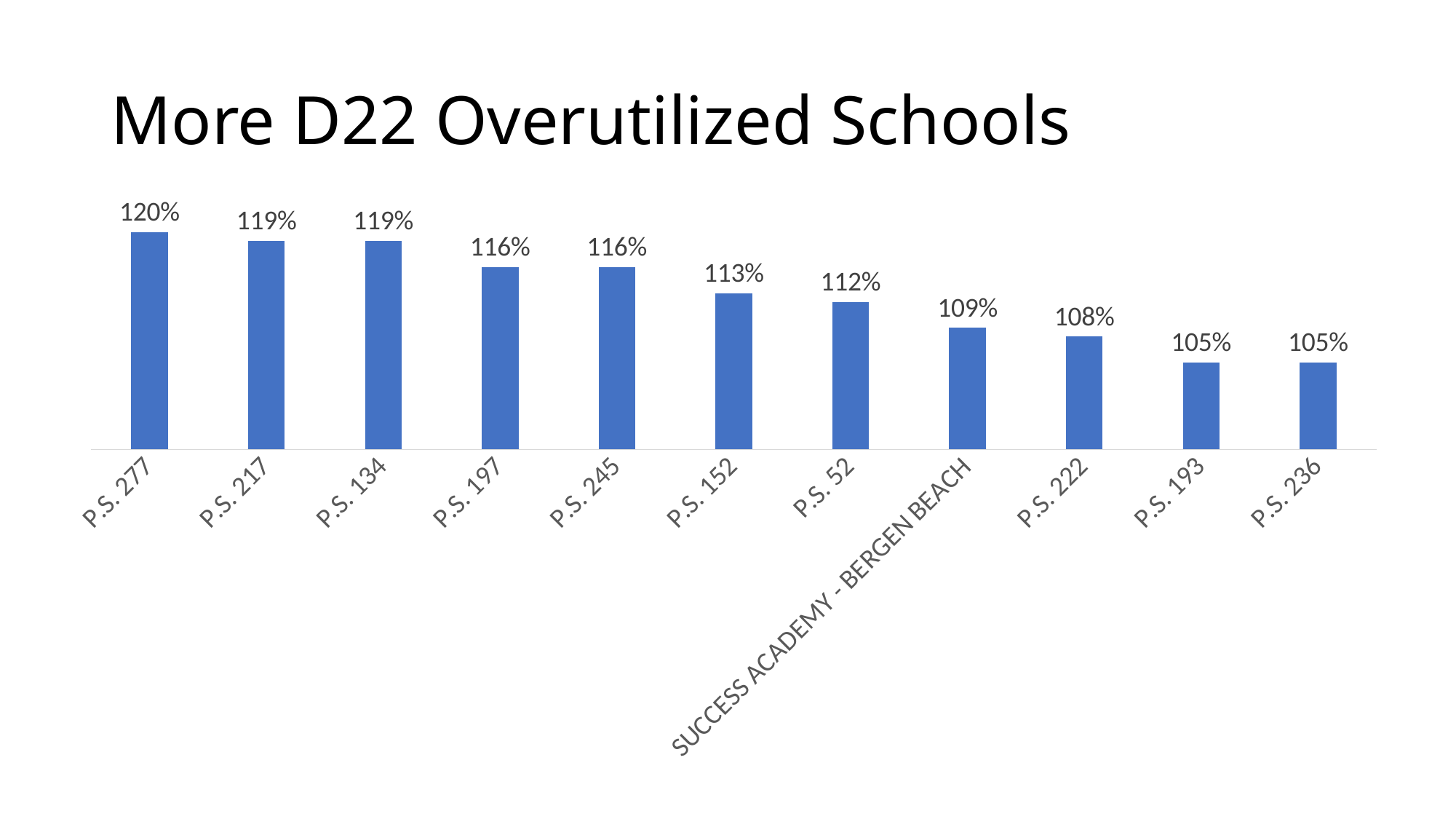
What is the value for SUCCESS ACADEMY - BERGEN BEACH? 109% What is the value for P.S. 152? 113% What is the difference between the values for P.S. 197 and P.S. 52? 4% How many schools are shown in the chart? 11 Which is larger, the value for P.S. 217 or the value for P.S. 193? P.S. 217 Do the values rise or fall from left to right along the x axis? fall Which school has the highest value? P.S. 277 What is the difference between the values for P.S. 277 and P.S. 236? 15% What kind of chart is shown on the slide? bar chart What is the value for P.S. 277? 120% What is the title of the slide? More D22 Overutilized Schools What is the value for P.S. 222? 108%